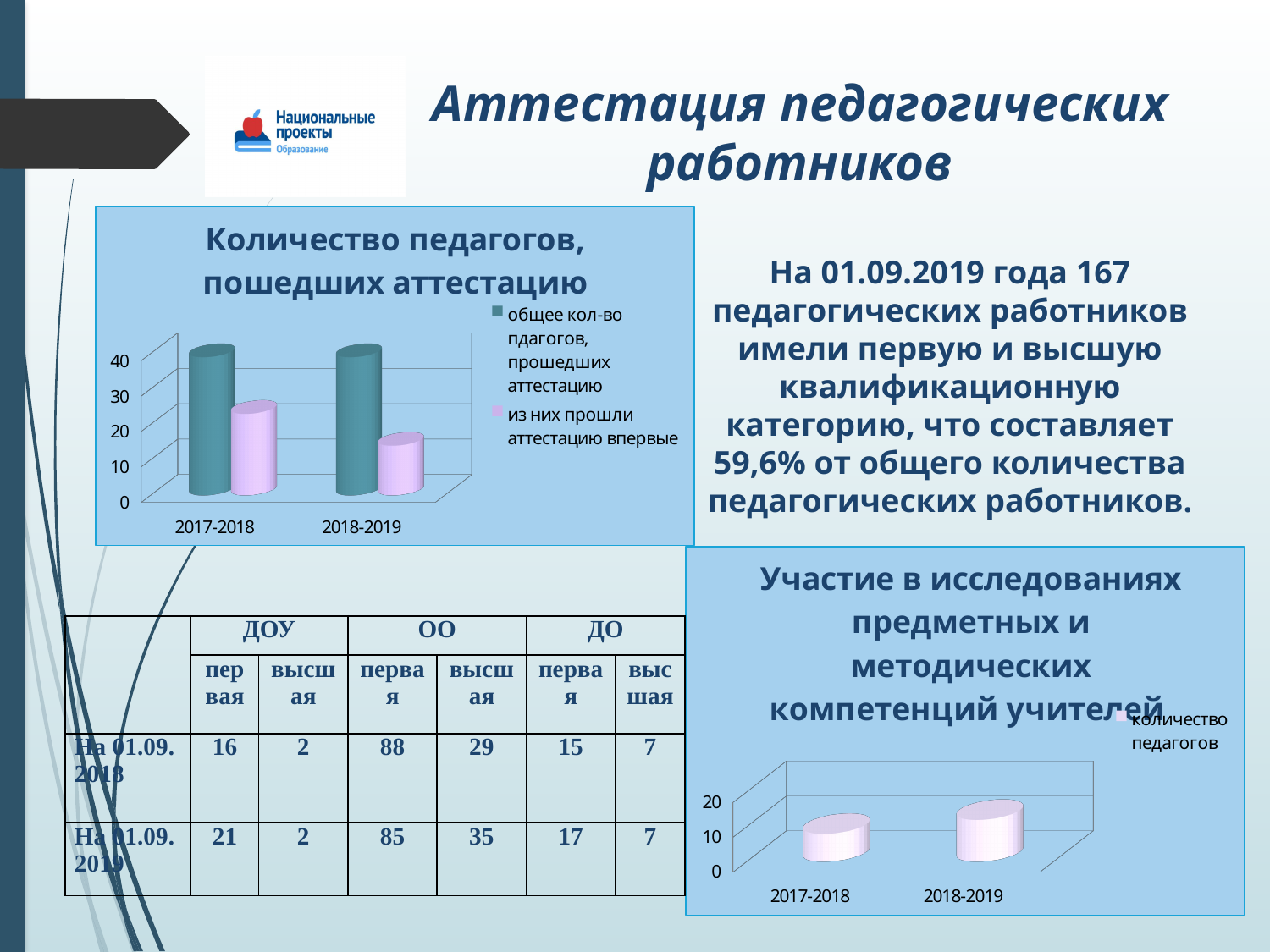
In the chart "Участие в исследованиях предметных и методических компетенций учителей", which year has the larger value, 2017-2018 or 2018-2019? 2018-2019 In the chart "Количество педагогов, пошедших аттестацию", which year has the larger value for "из них прошли аттестацию впервые", 2017-2018 or 2018-2019? 2017-2018 How many categories are shown on the x axis of the chart "Количество педагогов, пошедших аттестацию"? 2 How many series does the legend of the chart "Количество педагогов, пошедших аттестацию" list? 2 In the chart "Количество педагогов, пошедших аттестацию", is the value of "общее кол-во пдагогов, прошедших аттестацию" for 2017-2018 greater or less than 30? greater How many series does the legend of the chart "Участие в исследованиях предметных и методических компетенций учителей" list? 1 In the chart "Количество педагогов, пошедших аттестацию", is the value of "из них прошли аттестацию впервые" for 2017-2018 greater or less than 20? greater In the chart "Участие в исследованиях предметных и методических компетенций учителей", is the value for 2018-2019 greater or less than 20? less In the chart "Количество педагогов, пошедших аттестацию", does the series "из них прошли аттестацию впервые" rise or fall from 2017-2018 to 2018-2019? fall What kind of chart is the chart titled "Участие в исследованиях предметных и методических компетенций учителей"? bar chart What kind of chart is the chart titled "Количество педагогов, пошедших аттестацию"? bar chart